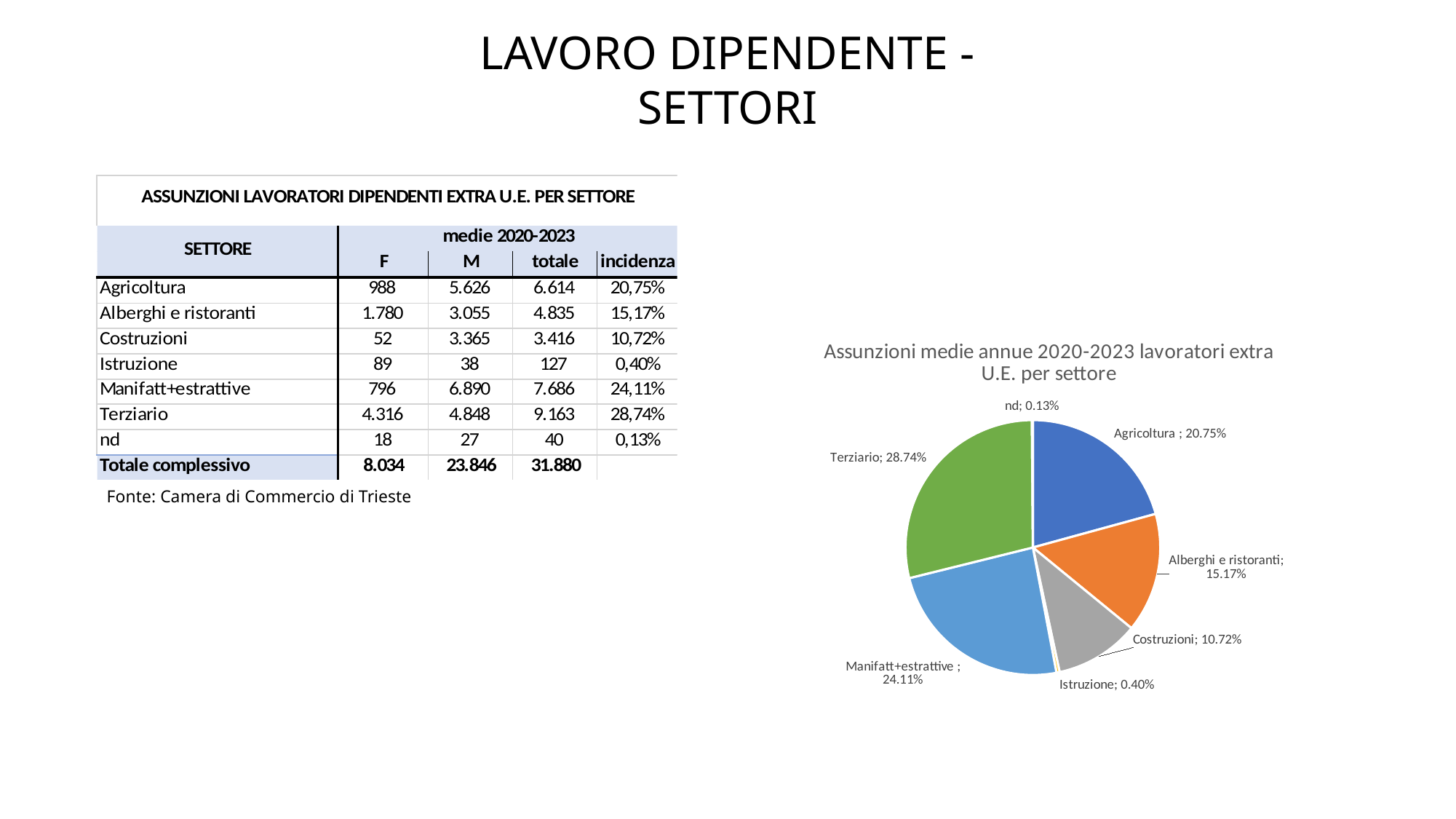
How many slices does the pie chart have? 7 What colour is the Terziario slice in the pie chart? green In the pie chart, what share does Agricoltura have? 20.75% In the pie chart, what share does Terziario have? 28.74% In the pie chart, what share does Costruzioni have? 10.72% What kind of chart is shown on the slide? pie chart What is the title of the pie chart? Assunzioni medie annue 2020-2023 lavoratori extra U.E. per settore In the pie chart, which is larger: Agricoltura or Alberghi e ristoranti? Agricoltura Which sector has the smallest slice in the pie chart? nd Which sector has the largest slice in the pie chart? Terziario In the pie chart, what is the difference in percentage points between Terziario and Manifatt+estrattive? 4.63